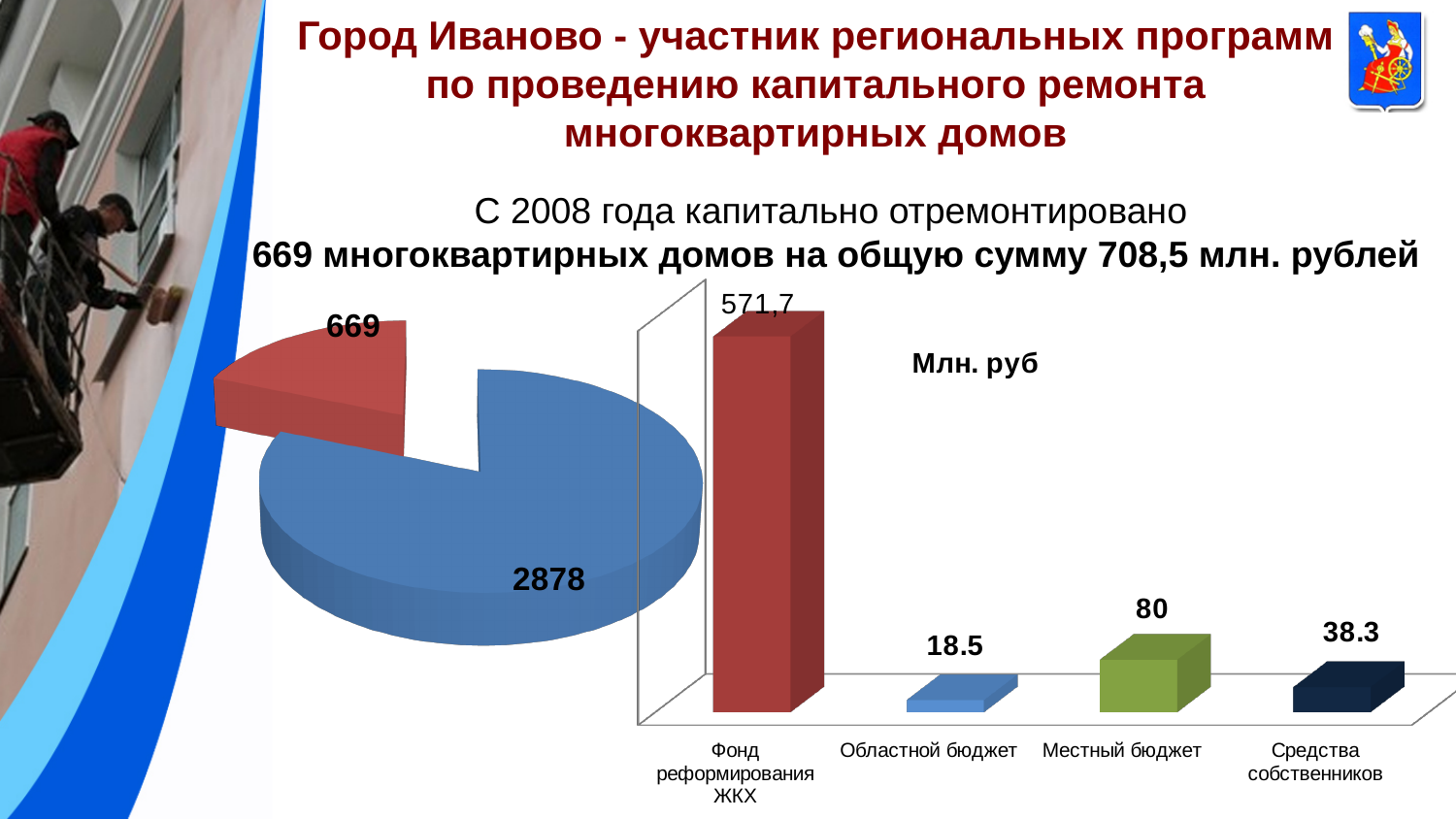
In the bar chart on the right, which is larger: Средства собственников or Местный бюджет? Местный бюджет In the bar chart on the right, what is the value for Фонд реформирования ЖКХ? 571,7 In the pie chart on the left, what is the difference between the two slice values, 2878 and 669? 2209 In the bar chart on the right, which category has the highest value? Фонд реформирования ЖКХ How many categories are shown in the bar chart on the right? 4 In the bar chart on the right, what is the value for Средства собственников? 38.3 In the bar chart on the right, what is the value for Областной бюджет? 18.5 In the pie chart on the left, what value is labelled on the red slice? 669 In the bar chart on the right, which category has the lowest value? Областной бюджет In the bar chart on the right, what is the difference between the values for Местный бюджет and Областной бюджет? 61.5 What kind of chart is the chart on the left of the slide? pie chart In the bar chart on the right, what is the value for Местный бюджет? 80